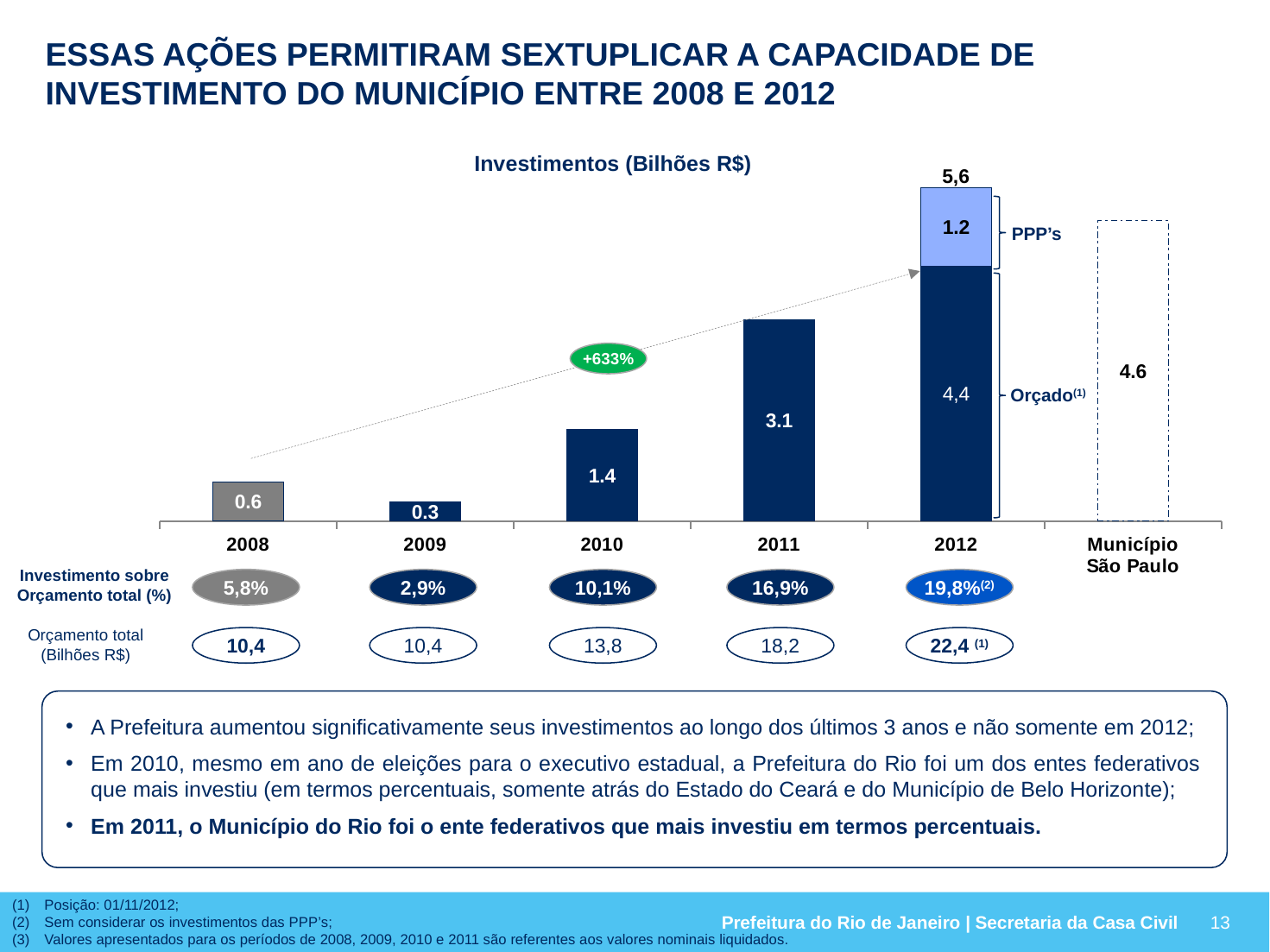
What is the investment value shown for Município São Paulo? 4.6 What is the difference between the investment values for 2011 and 2010? 1.7 What type of chart is shown on the slide? bar chart What is the title of the chart? Investimentos (Bilhões R$) What percentage growth is shown in the green callout on the chart? +633% What is the investment value for 2010? 1.4 Which year from 2008 to 2012 has the lowest investment value? 2009 Which is larger, the investment value for 2008 or for 2009? 2008 What is the PPP's portion of the 2012 bar? 1.2 Do the investment values rise or fall from 2009 to 2012? rise What is the total of the stacked 2012 bar? 5,6 What is the investment value for 2011? 3.1